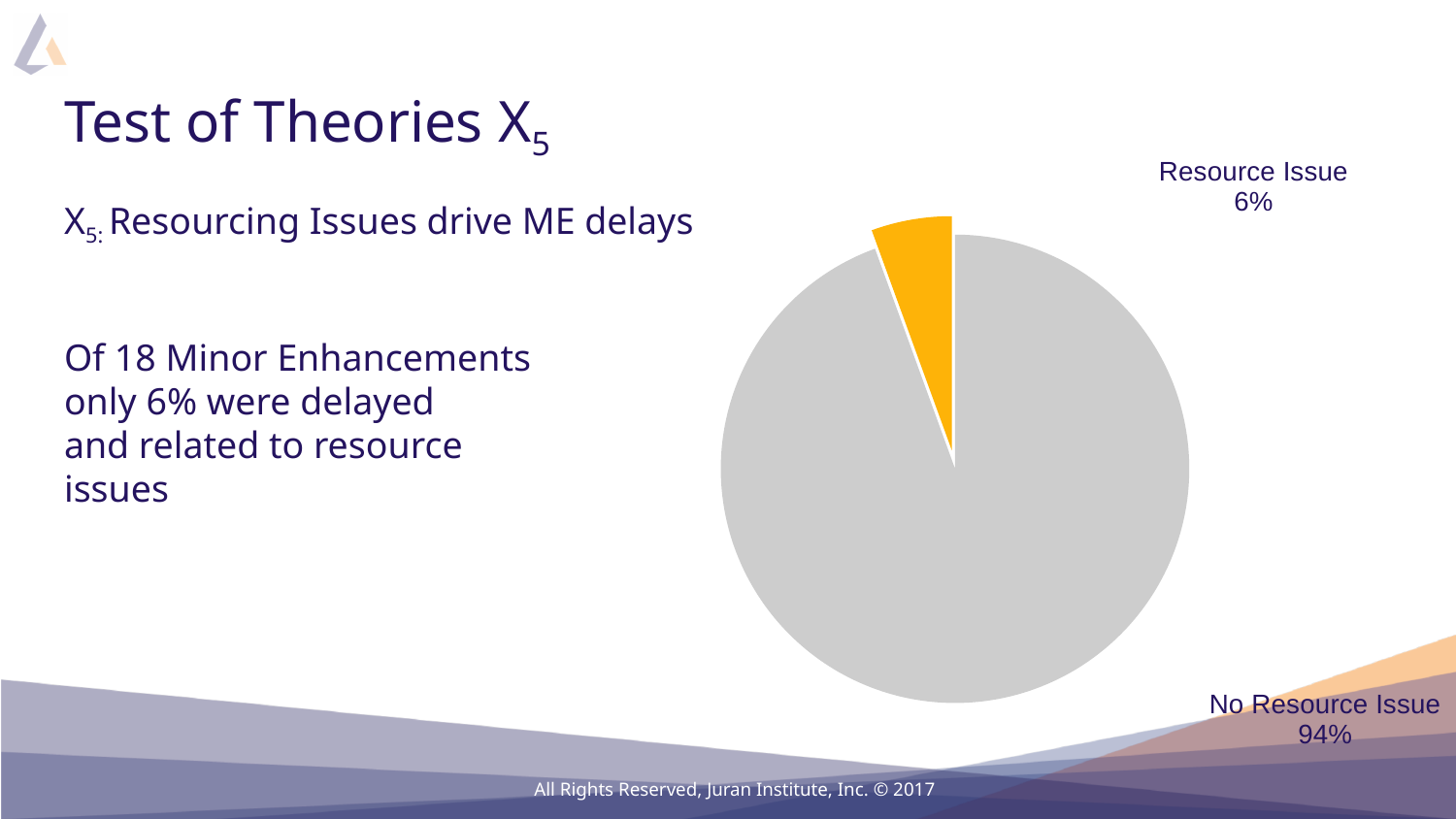
Which slice of the pie is the smallest? Resource Issue What is the total of the two pie slice percentages? 100% Which is larger, the Resource Issue slice or the No Resource Issue slice? No Resource Issue What share of the pie is labelled Resource Issue? 6% What colour is the Resource Issue slice? orange Which slice of the pie is the largest? No Resource Issue What kind of chart is shown on the slide? pie chart How many slices does the pie chart have? 2 What is the difference in percentage points between the No Resource Issue slice and the Resource Issue slice? 88 What share of the pie is labelled No Resource Issue? 94% What colour is the No Resource Issue slice? grey